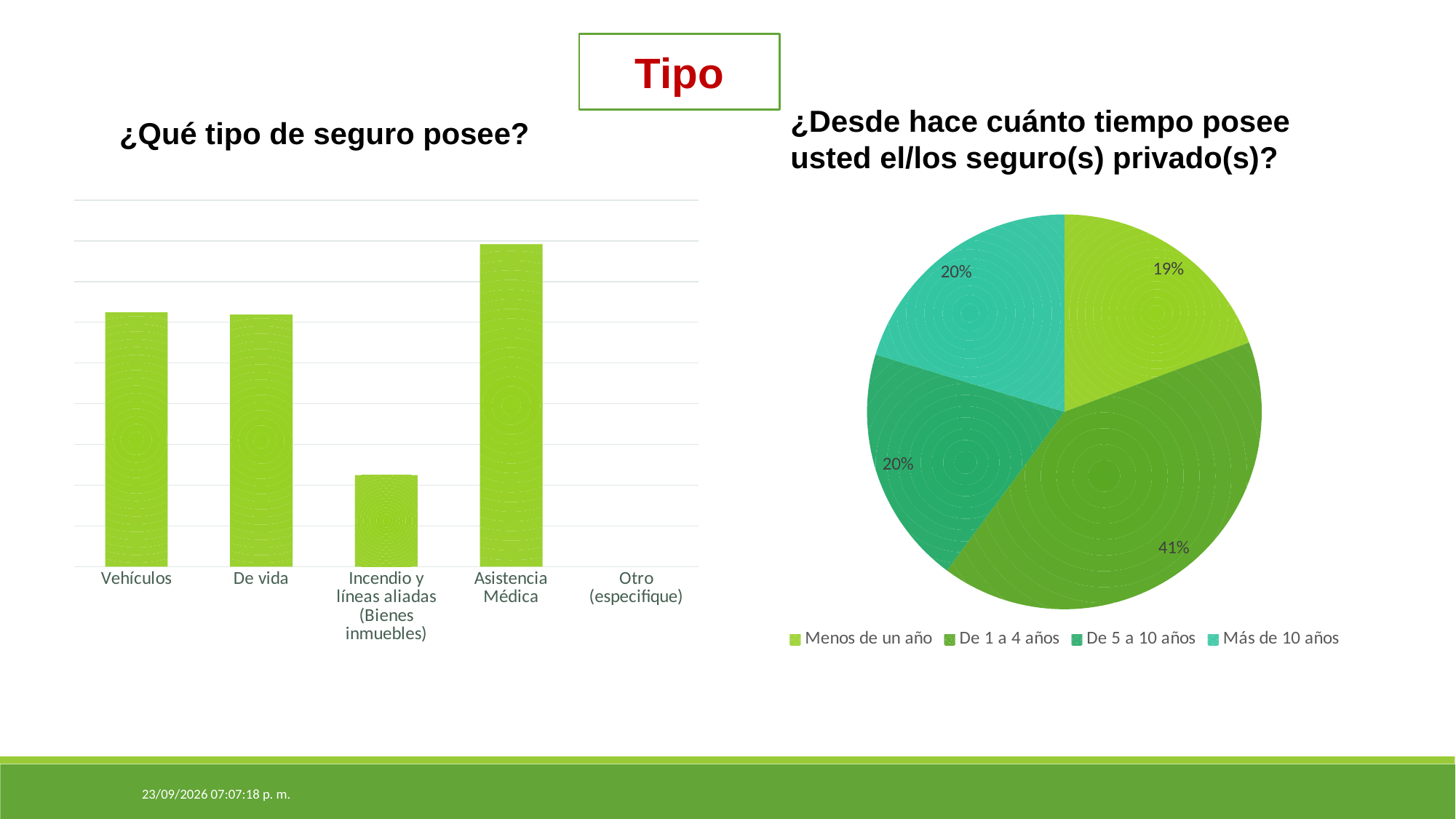
In the chart titled '¿Qué tipo de seguro posee?', how many categories are shown on the x axis? 5 In the pie chart on the right, which category has the largest share? De 1 a 4 años What kind of chart is the one titled '¿Qué tipo de seguro posee?'? Bar chart In the pie chart on the right, what percentage is shown for 'Más de 10 años'? 20% In the chart titled '¿Qué tipo de seguro posee?', which category with a visible bar has the shortest bar? Incendio y líneas aliadas (Bienes inmuebles) How many entries does the legend of the pie chart on the right list? 4 In the pie chart on the right, what percentage is shown for 'De 1 a 4 años'? 41% In the pie chart on the right, what is the difference in percentage points between 'De 1 a 4 años' and 'Menos de un año'? 22 In the chart titled '¿Qué tipo de seguro posee?', which category has the tallest bar? Asistencia Médica In the chart titled '¿Qué tipo de seguro posee?', which is larger, the bar for Vehículos or the bar for Incendio y líneas aliadas (Bienes inmuebles)? Vehículos In the pie chart on the right, what percentage is shown for 'Menos de un año'? 19% In the pie chart on the right, which category has the smallest share? Menos de un año